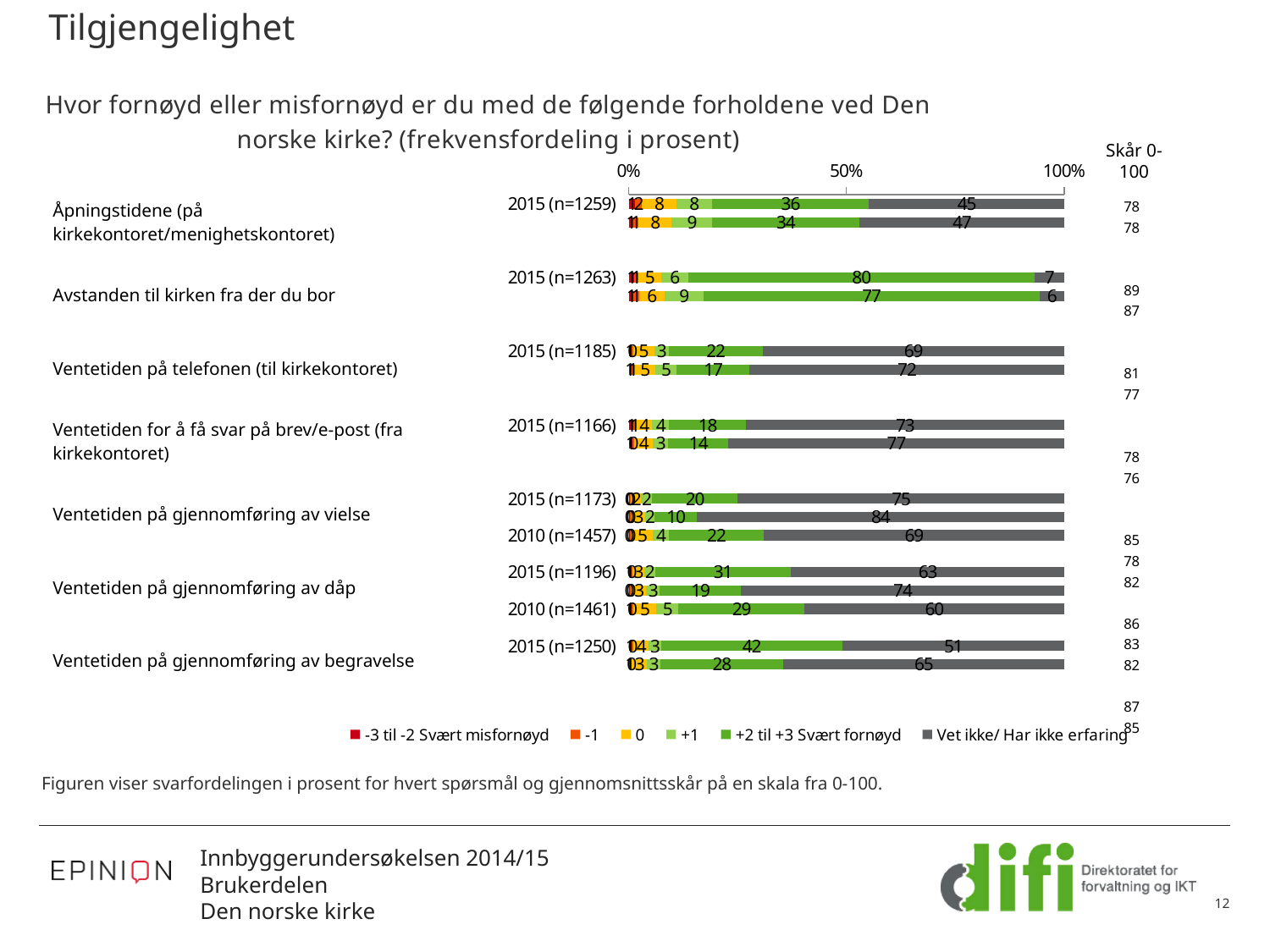
What is the difference between the '+2 til +3 Svært fornøyd' value for 'Avstanden til kirken fra der du bor' 2015 (n=1263) and for 'Åpningstidene' 2015 (n=1259)? 44 What is the value of '+2 til +3 Svært fornøyd' for 'Ventetiden på gjennomføring av begravelse' in 2015 (n=1250)? 42 What is the value of '+2 til +3 Svært fornøyd' for 'Avstanden til kirken fra der du bor' in 2015 (n=1263)? 80 What is the label of the last legend entry (the dark grey series)? Vet ikke/ Har ikke erfaring How many series does the legend list? 6 What is the value of 'Vet ikke/ Har ikke erfaring' for 'Åpningstidene (på kirkekontoret/menighetskontoret)' in 2015 (n=1259)? 45 What is the value of 'Vet ikke/ Har ikke erfaring' for 'Ventetiden på gjennomføring av vielse' in 2010 (n=1457)? 69 Is the 'Vet ikke/ Har ikke erfaring' value for 'Avstanden til kirken fra der du bor' 2015 (n=1263) greater or less than 50%? less How many question items (categories) are listed down the left side of the chart? 7 What kind of chart is shown on the slide? bar chart Which is larger: the '+2 til +3 Svært fornøyd' value for 'Ventetiden på gjennomføring av begravelse' 2015 (n=1250) or for 'Ventetiden på gjennomføring av dåp' 2015 (n=1196)? Ventetiden på gjennomføring av begravelse Among the 2015 bars, which item has the highest value for '+2 til +3 Svært fornøyd'? Avstanden til kirken fra der du bor